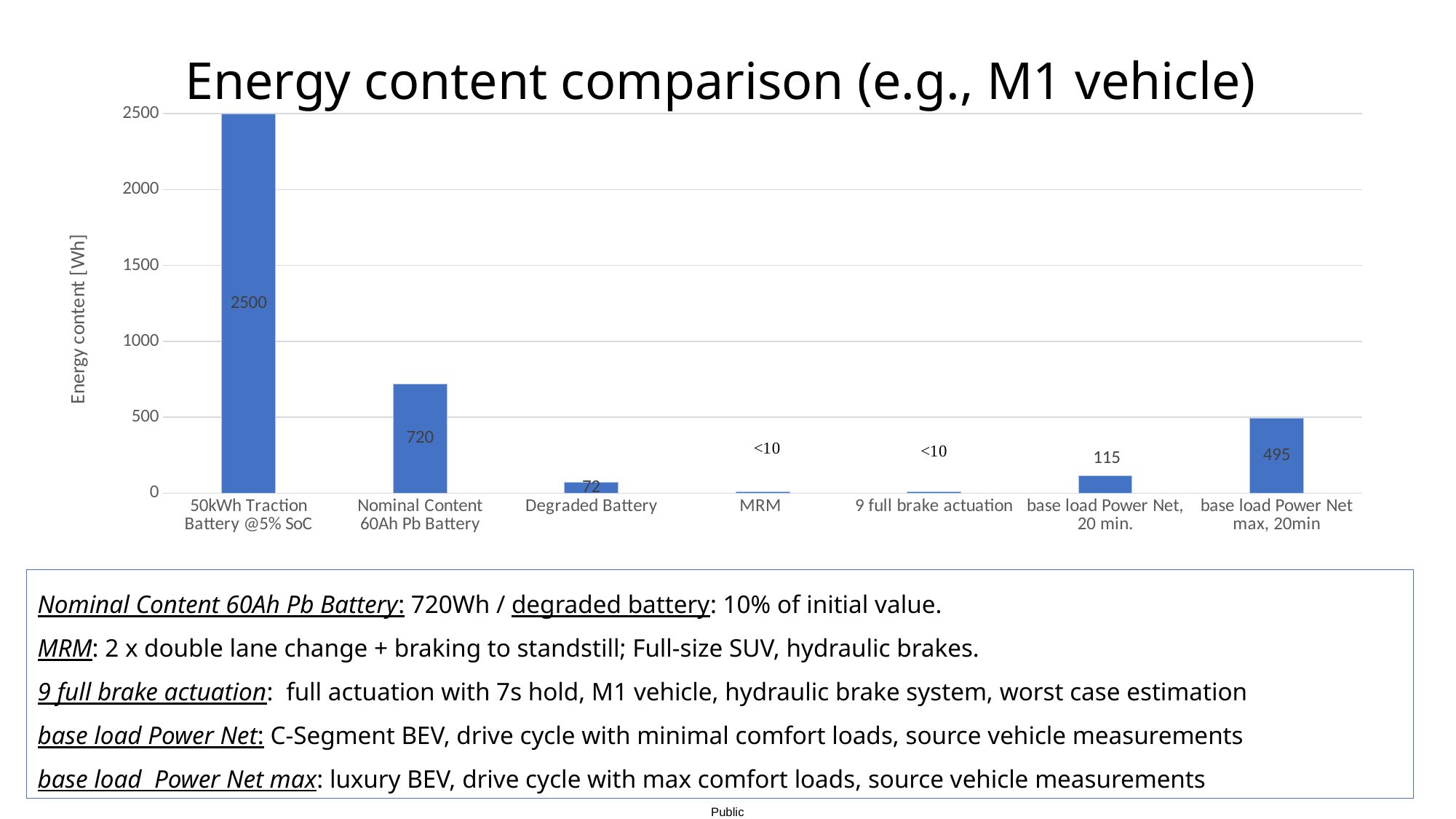
What is the label of the y axis? Energy content [Wh] What is the value for Nominal Content 60Ah Pb Battery? 720 What label is shown for the MRM bar? <10 What is the value for base load Power Net, 20 min.? 115 What is the difference between Nominal Content 60Ah Pb Battery and Degraded Battery? 648 Which category has the highest value? 50kWh Traction Battery @5% SoC Which is larger, base load Power Net max, 20min or base load Power Net, 20 min.? base load Power Net max, 20min What kind of chart is this? bar chart How many categories are shown on the x axis? 7 What is the value for base load Power Net max, 20min? 495 What is the value for Degraded Battery? 72 What is the value for 50kWh Traction Battery @5% SoC? 2500